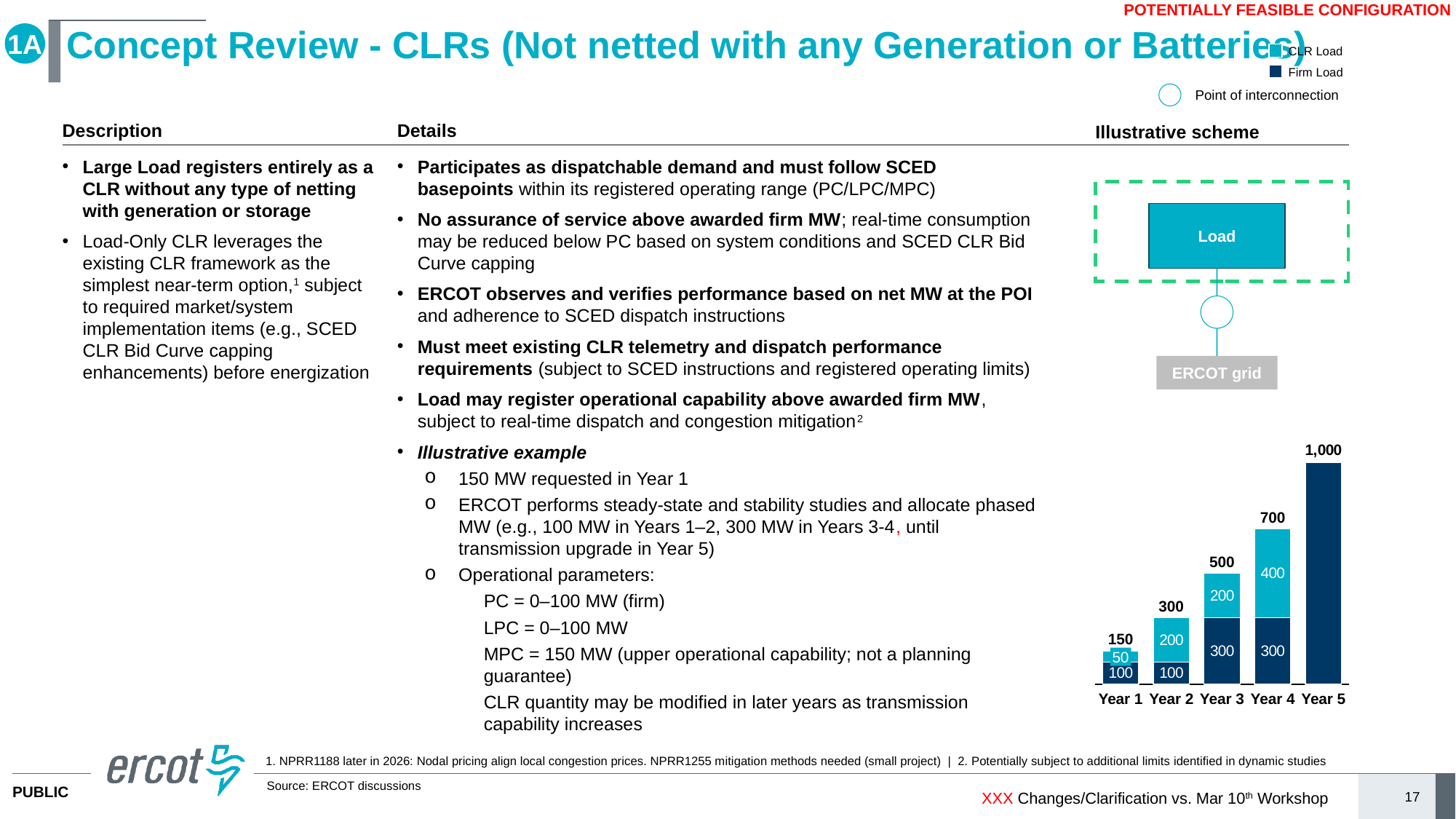
Which year has the highest total in the bar chart? Year 5 How many series does the legend list for the bar chart? 2 Which year has the lowest total in the bar chart? Year 1 What is the difference between the total for Year 4 and the total for Year 3? 200 What is the total value labelled above the Year 5 bar? 1,000 What is the Firm Load value for Year 3 in the bar chart? 300 Which is larger: the CLR Load in Year 2 or the CLR Load in Year 4? Year 4 What is the CLR Load value for Year 1 in the bar chart? 50 What is the CLR Load value for Year 4 in the bar chart? 400 What type of chart is shown at the bottom right of the slide? Stacked bar chart Do the total values rise or fall from Year 1 to Year 5 in the bar chart? Rise How many years (categories) are shown on the x axis of the bar chart? 5